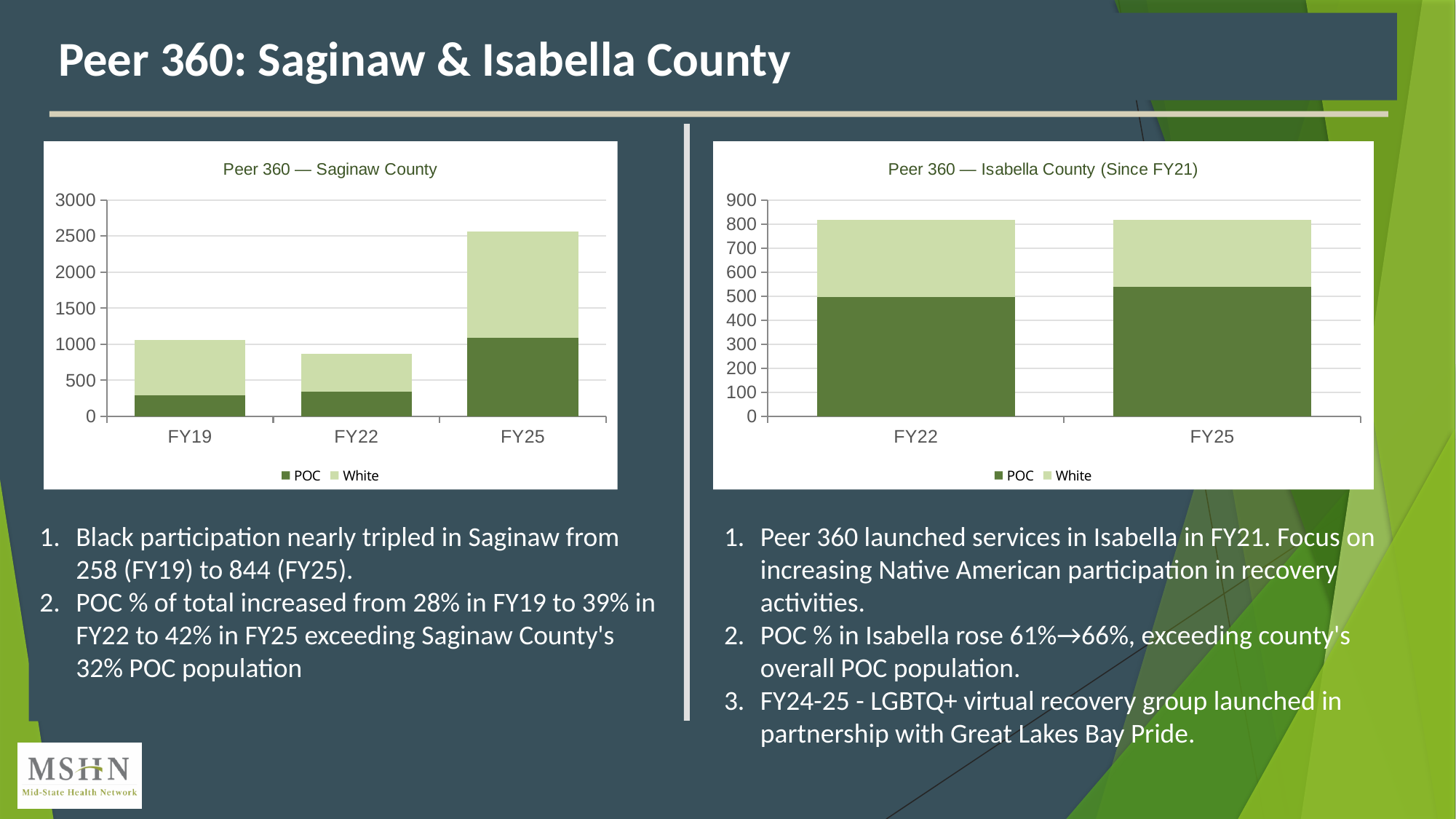
In the Peer 360 — Isabella County (Since FY21) chart, is the POC segment for FY22 greater or less than 400? greater What kind of chart is the Peer 360 — Saginaw County chart? stacked bar chart In the Peer 360 — Saginaw County chart, is the POC segment for FY19 greater or less than 500? less In the Peer 360 — Isabella County (Since FY21) chart, is the total bar for FY25 greater or less than 900? less In the Peer 360 — Saginaw County chart, which fiscal year has the tallest total bar? FY25 In the Peer 360 — Saginaw County chart, which fiscal year has the shortest total bar? FY22 How many fiscal years are shown on the x axis of the Peer 360 — Isabella County (Since FY21) chart? 2 How many fiscal years are shown on the x axis of the Peer 360 — Saginaw County chart? 3 In the Peer 360 — Saginaw County chart, is the POC segment for FY25 larger than the POC segment for FY22? Yes In the Peer 360 — Saginaw County chart, which series is shown in the darker green colour? POC How many series does the legend of the Peer 360 — Isabella County (Since FY21) chart list? 2